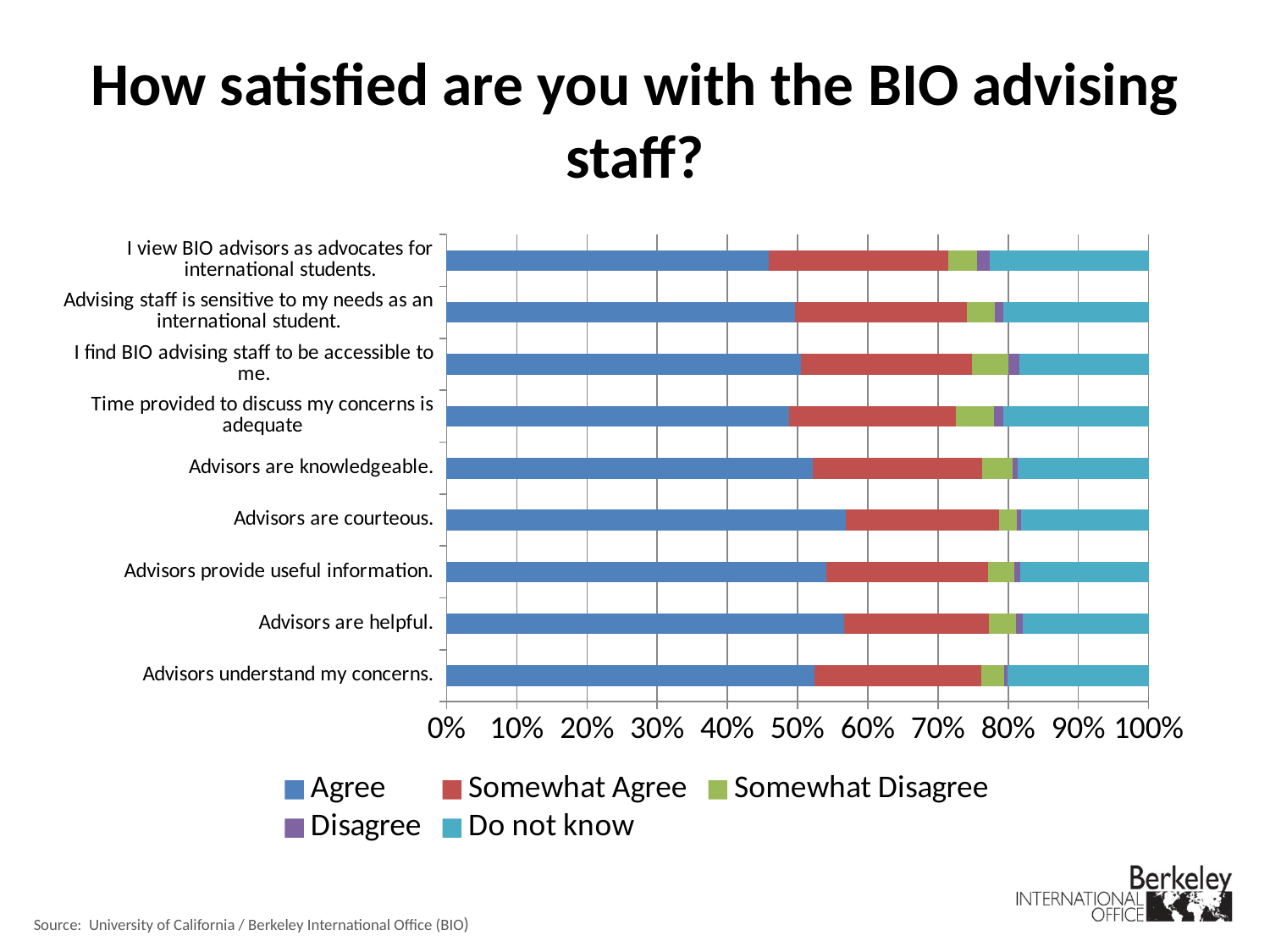
What is the title of the chart? How satisfied are you with the BIO advising staff? Is the 'Agree' share for 'I view BIO advisors as advocates for international students.' greater or less than 50%? less Which statement has the smallest 'Agree' segment? I view BIO advisors as advocates for international students. Which response category is shown in blue in the legend? Agree Is the 'Agree' share for 'Advisors provide useful information.' greater or less than 50%? greater How many statements (categories) are listed on the vertical axis of the chart? 9 Is the 'Agree' share for 'Advisors are helpful.' greater or less than 50%? greater What is the maximum value shown on the horizontal axis? 100% Which has a larger 'Agree' segment: 'Advisors are courteous.' or 'I view BIO advisors as advocates for international students.'? Advisors are courteous. How many series does the legend list? 5 What kind of chart is shown on the slide? Stacked bar chart